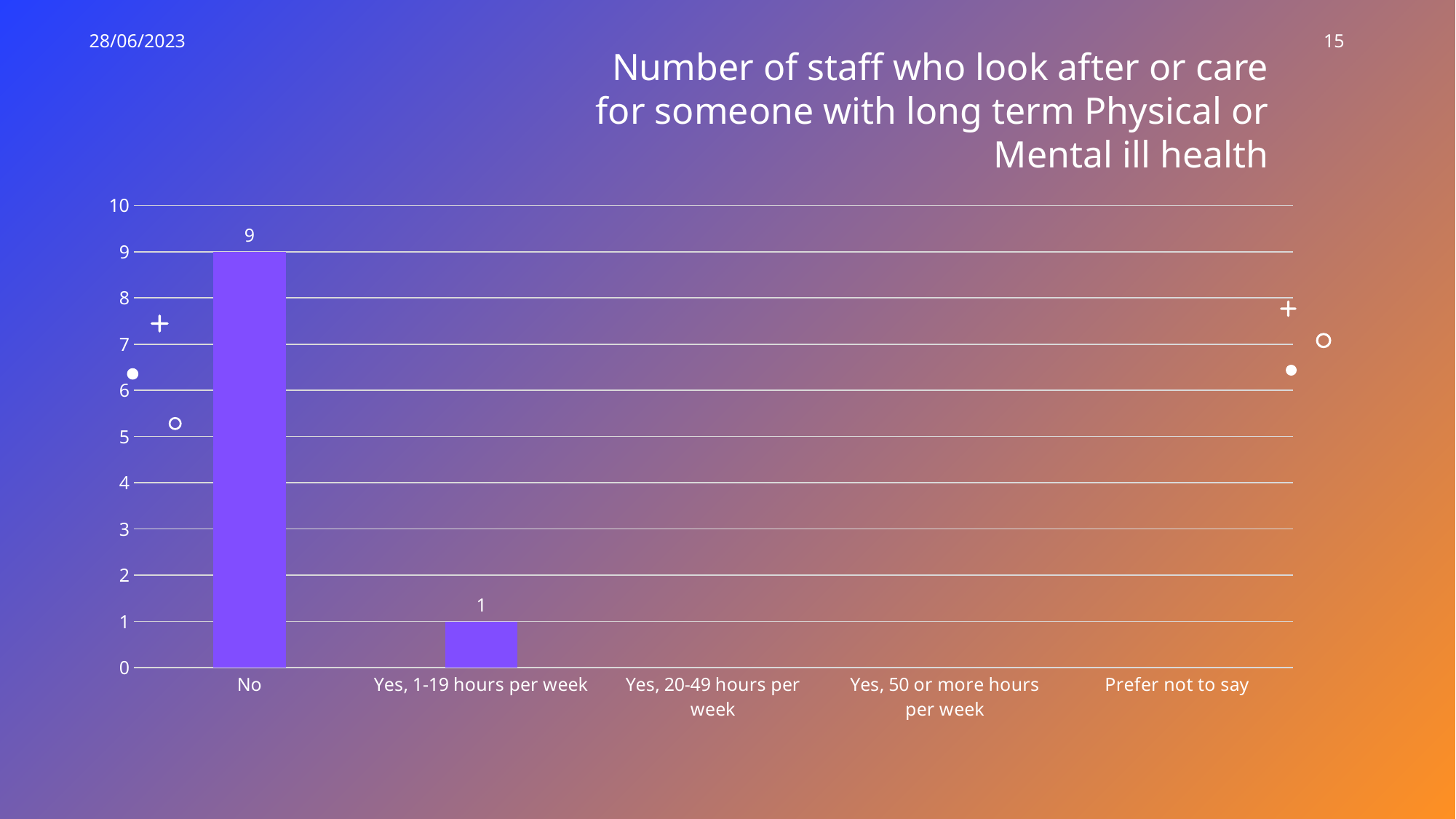
What is the value for "No"? 9 Which is larger, the value for "No" or the value for "Yes, 1-19 hours per week"? No Which category has the highest value? No What kind of chart is shown on the slide? bar chart Do the values rise or fall from "No" to "Yes, 1-19 hours per week"? fall What is the value for "Yes, 1-19 hours per week"? 1 What is the maximum value shown on the y axis? 10 What is the difference between the values for "No" and "Yes, 1-19 hours per week"? 8 Is the value for "No" greater or less than 5? greater What is the title of the chart? Number of staff who look after or care for someone with long term Physical or Mental ill health How many categories are shown on the x axis? 5